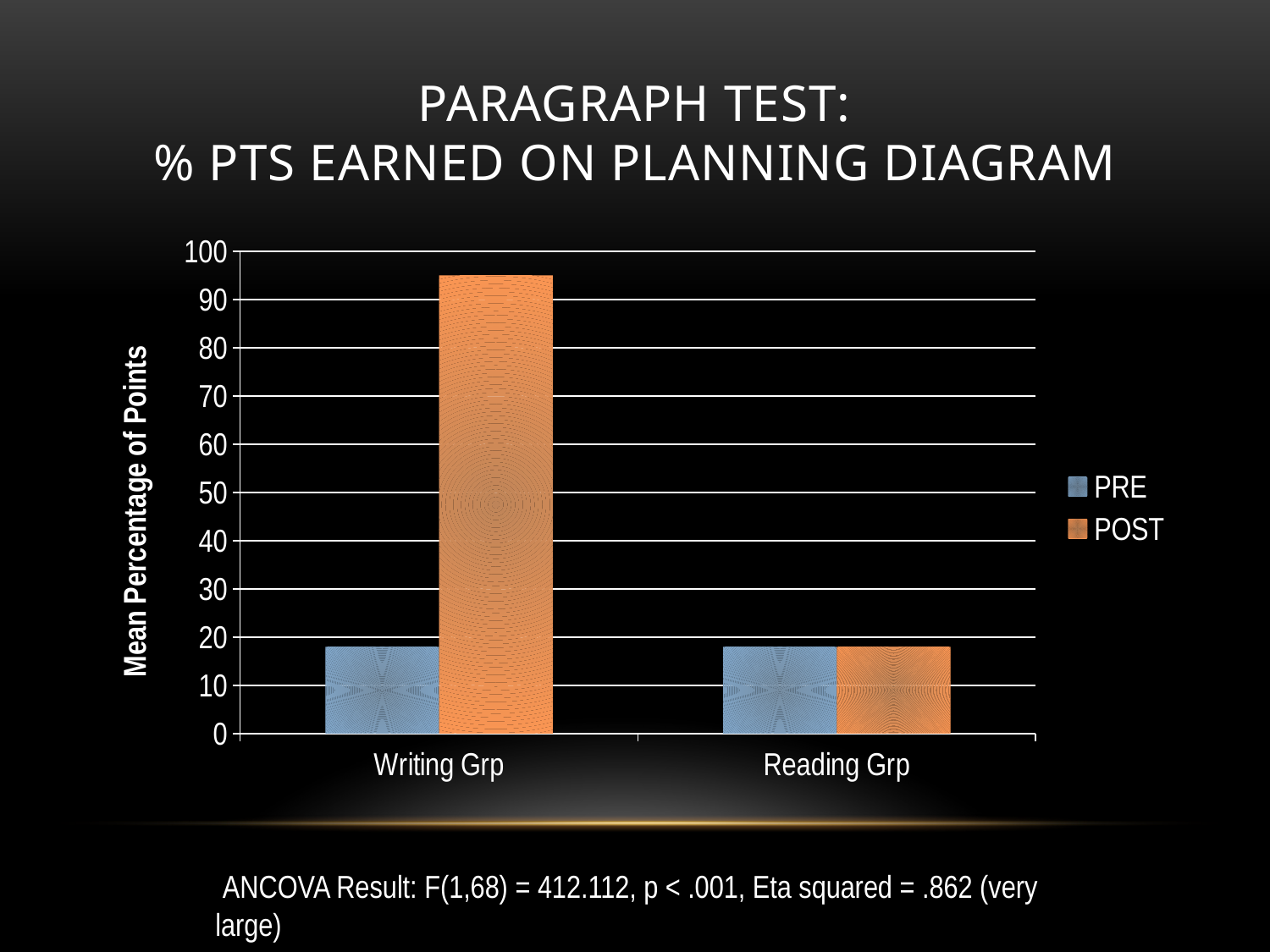
Is the PRE value for Reading Grp greater or less than 10? greater Is the PRE value for Writing Grp greater or less than 20? less How many series does the legend list? 2 Which is larger, the POST value for Writing Grp or the POST value for Reading Grp? Writing Grp Is the POST value for Writing Grp greater or less than 90? greater What is the label of the y axis? Mean Percentage of Points How many groups are shown on the x axis? 2 For Writing Grp, which is larger, the PRE value or the POST value? POST What kind of chart is shown on the slide? bar chart Which group and series has the highest bar? Writing Grp, POST Which colour represents the POST series in the legend? orange